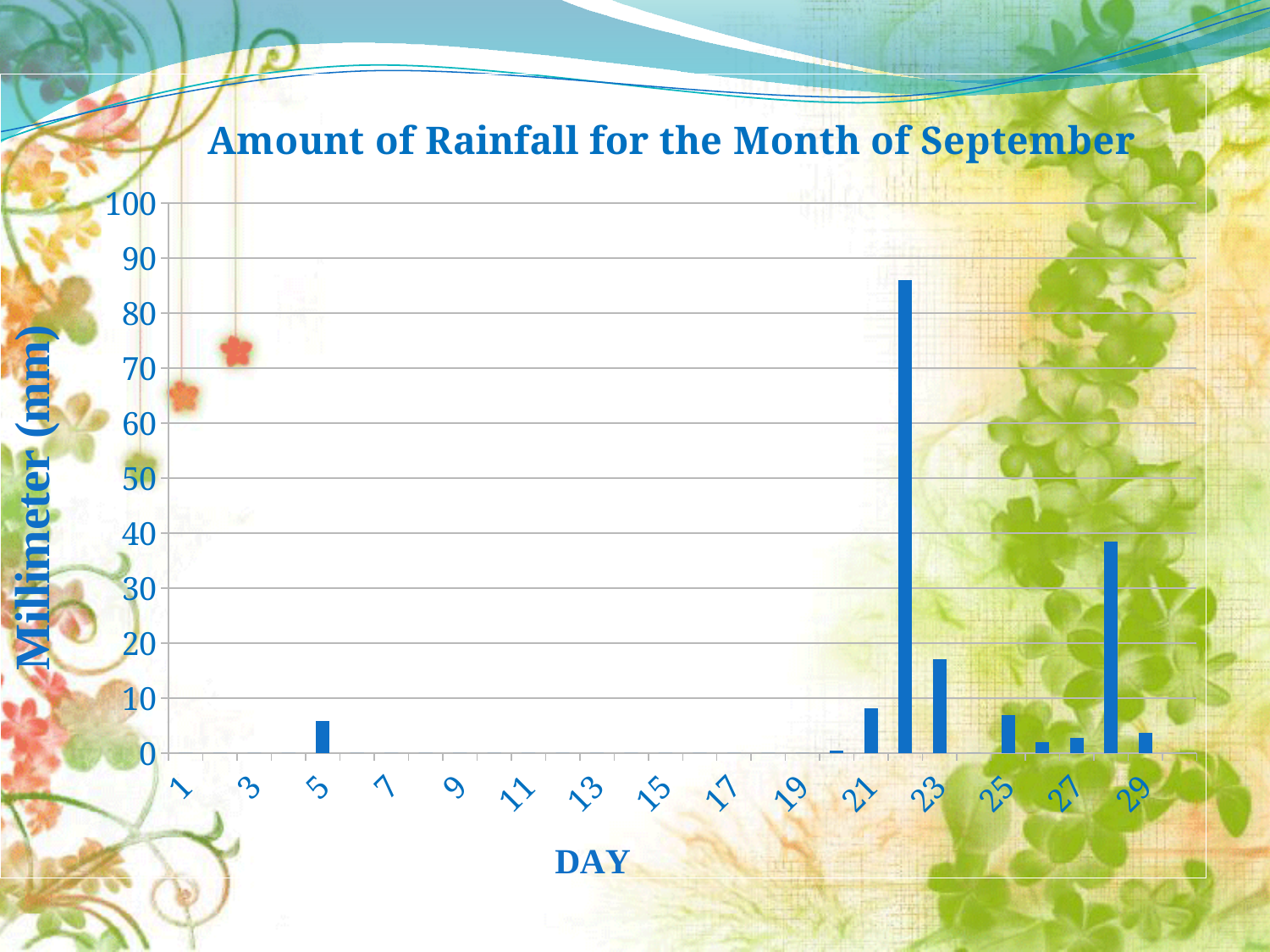
Which day has more rainfall, day 23 or day 5? 23 Is the rainfall value for day 5 greater or less than 10? less Is the rainfall value for day 23 greater or less than 20? less Which day has more rainfall, day 22 or day 28? 22 How many day labels are shown along the horizontal axis? 15 What is the highest value shown on the vertical axis? 100 What is the title of the chart? Amount of Rainfall for the Month of September What is the label of the vertical axis? Millimeter (mm) Is the rainfall value for day 28 greater or less than 30? greater What type of chart is shown on the slide? Bar chart Which day has the highest amount of rainfall? 22